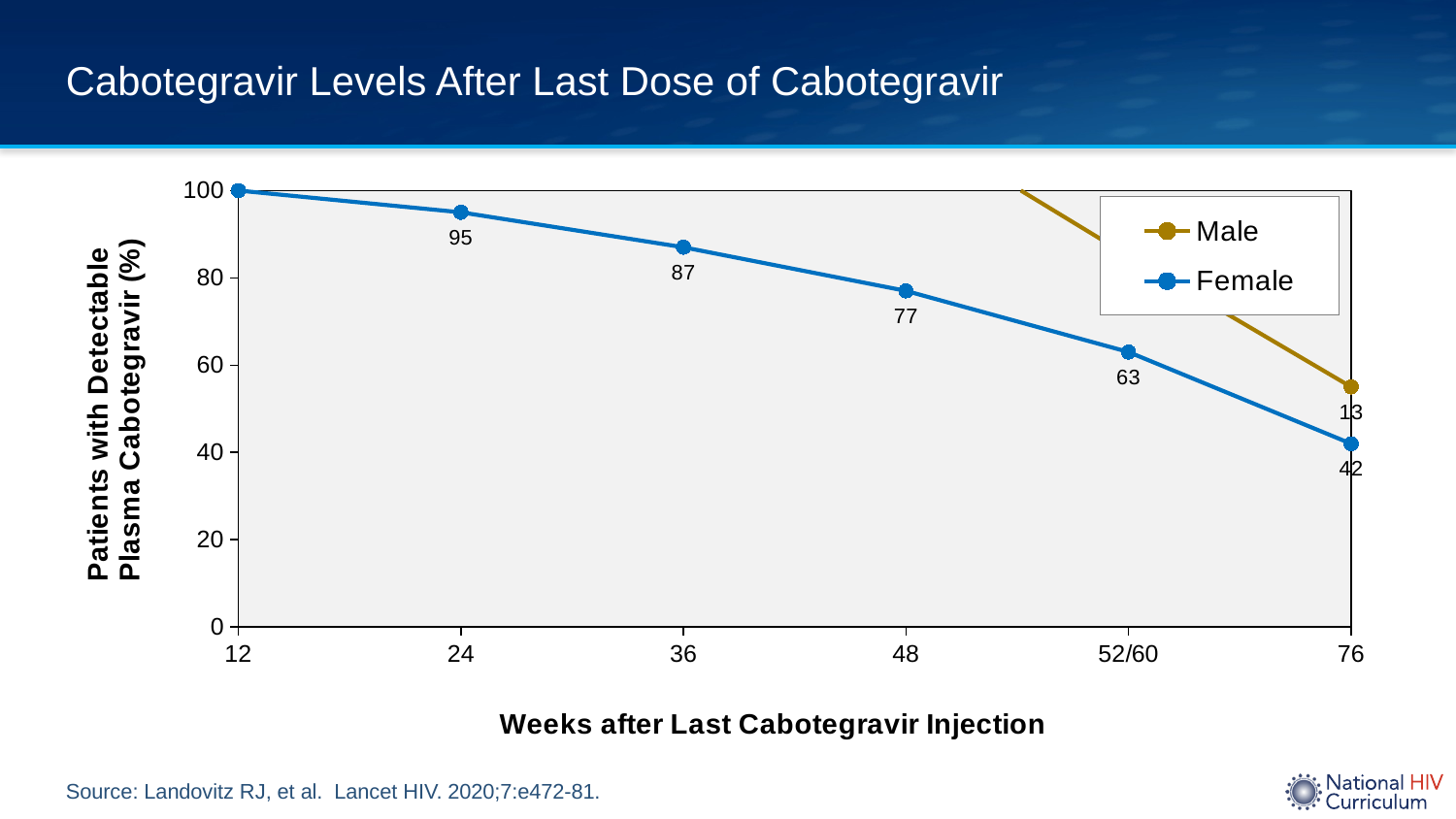
What is the value for Female at 76 weeks? 42 What is the value for Female at 52/60 weeks? 63 What is the difference between the Female values at 36 weeks and 48 weeks? 10 What is the value for Female at 24 weeks after last cabotegravir injection? 95 How many time points are shown on the x axis? 6 What is the title of the x axis? Weeks after Last Cabotegravir Injection How many series does the legend list? 2 What kind of chart is shown on the slide? line chart What is the value for Female at 48 weeks? 77 Does the Female line rise or fall as weeks after last injection increase? fall What is the difference between the Female values at 24 weeks and 76 weeks? 53 What is the value for Female at 36 weeks? 87